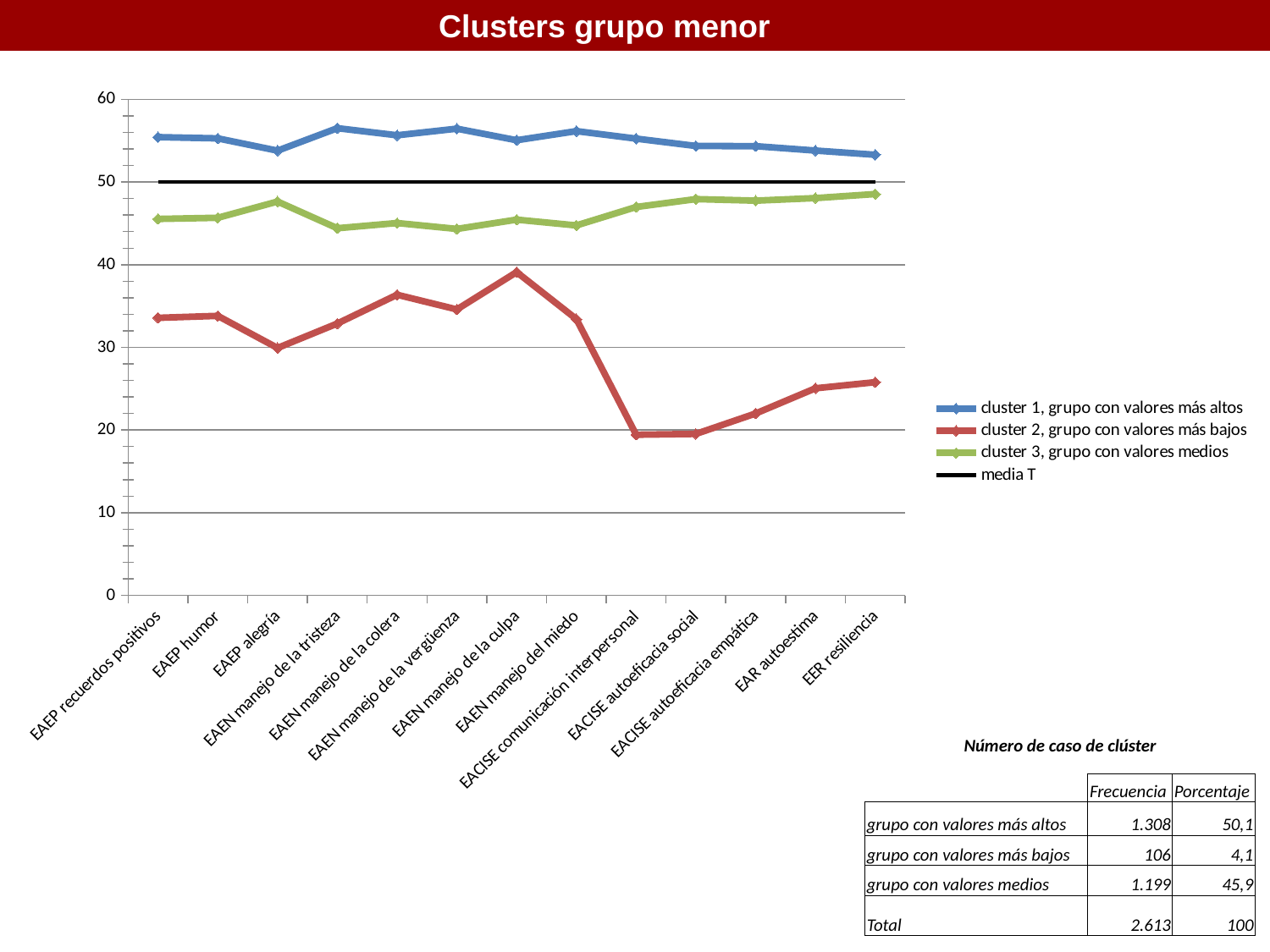
Which series is higher at EAR autoestima: cluster 1 (grupo con valores más altos) or cluster 3 (grupo con valores medios)? cluster 1, grupo con valores más altos What kind of chart is shown on the slide? line chart Is the value of cluster 3 (grupo con valores medios) for EAEP alegría greater or less than 50? less At what value does the flat 'media T' line sit on the y axis? 50 Does the cluster 3 (grupo con valores medios) line rise or fall from EAEN manejo del miedo to EER resiliencia? rise How many categories are plotted along the x axis of the chart? 13 Is the value of cluster 2 (grupo con valores más bajos) for EAEN manejo de la culpa greater or less than 30? greater For which category does cluster 2 (grupo con valores más bajos) reach its highest value? EAEN manejo de la culpa What is the title of the slide containing the chart? Clusters grupo menor Is the value of cluster 2 (grupo con valores más bajos) for EACISE comunicación interpersonal greater or less than 30? less How many series does the chart legend list? 4